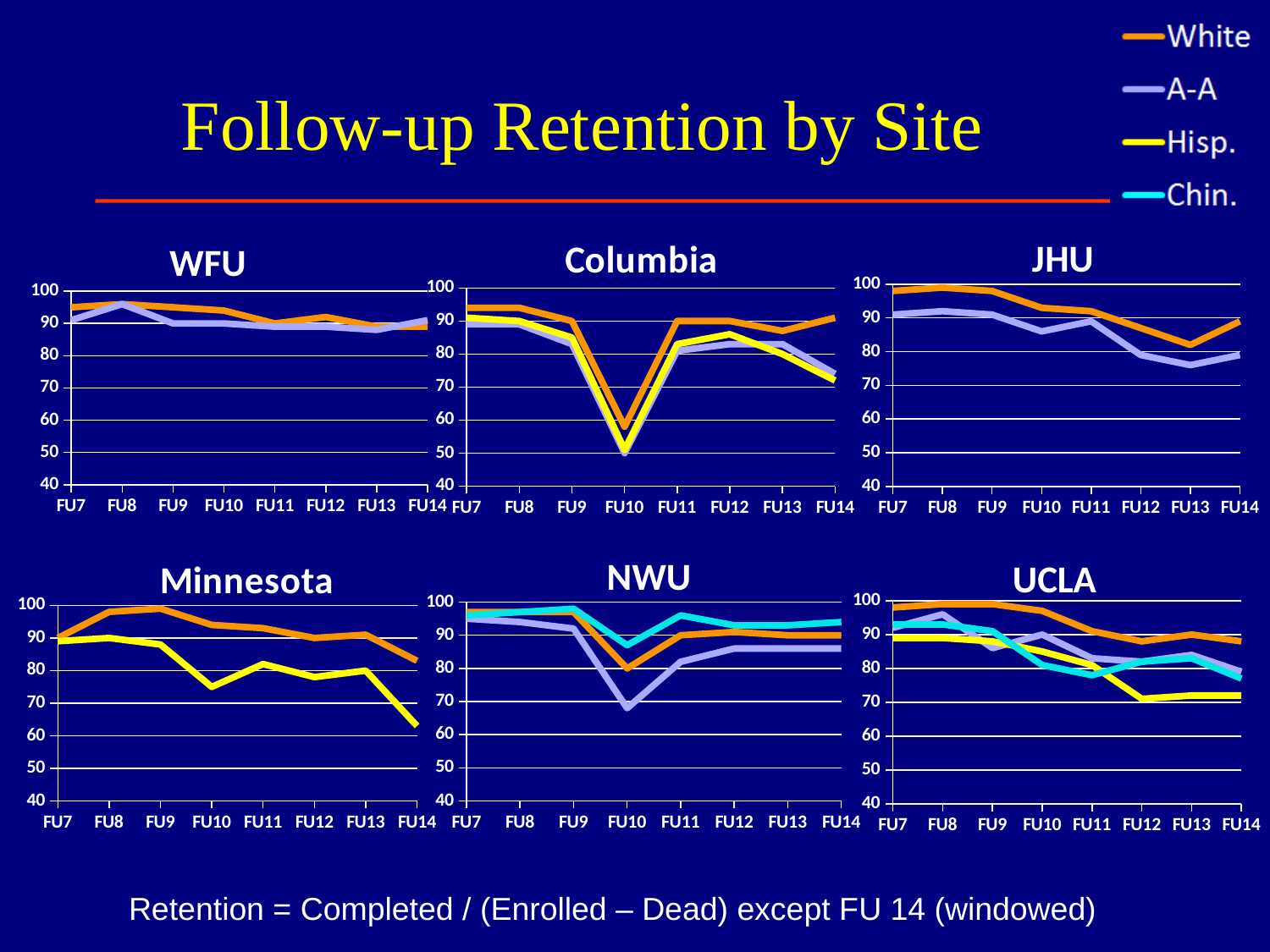
In the Columbia chart, is the A-A value at FU10 greater or less than 60? less In the NWU chart, is the A-A value at FU10 greater or less than 80? less How many charts are shown on the slide? 6 In the Minnesota chart, is the Hisp. value at FU14 greater or less than 70? less In the JHU chart, does the A-A series rise or fall overall from FU7 to FU14? fall How many series does the legend at the top right list? 4 In the Columbia chart, at which follow-up is the White series lowest? FU10 In the Minnesota chart, at FU14, which is larger: the White value or the Hisp. value? White How many follow-up points are shown on the x axis of the Columbia chart? 8 What kind of chart is the WFU chart? line chart